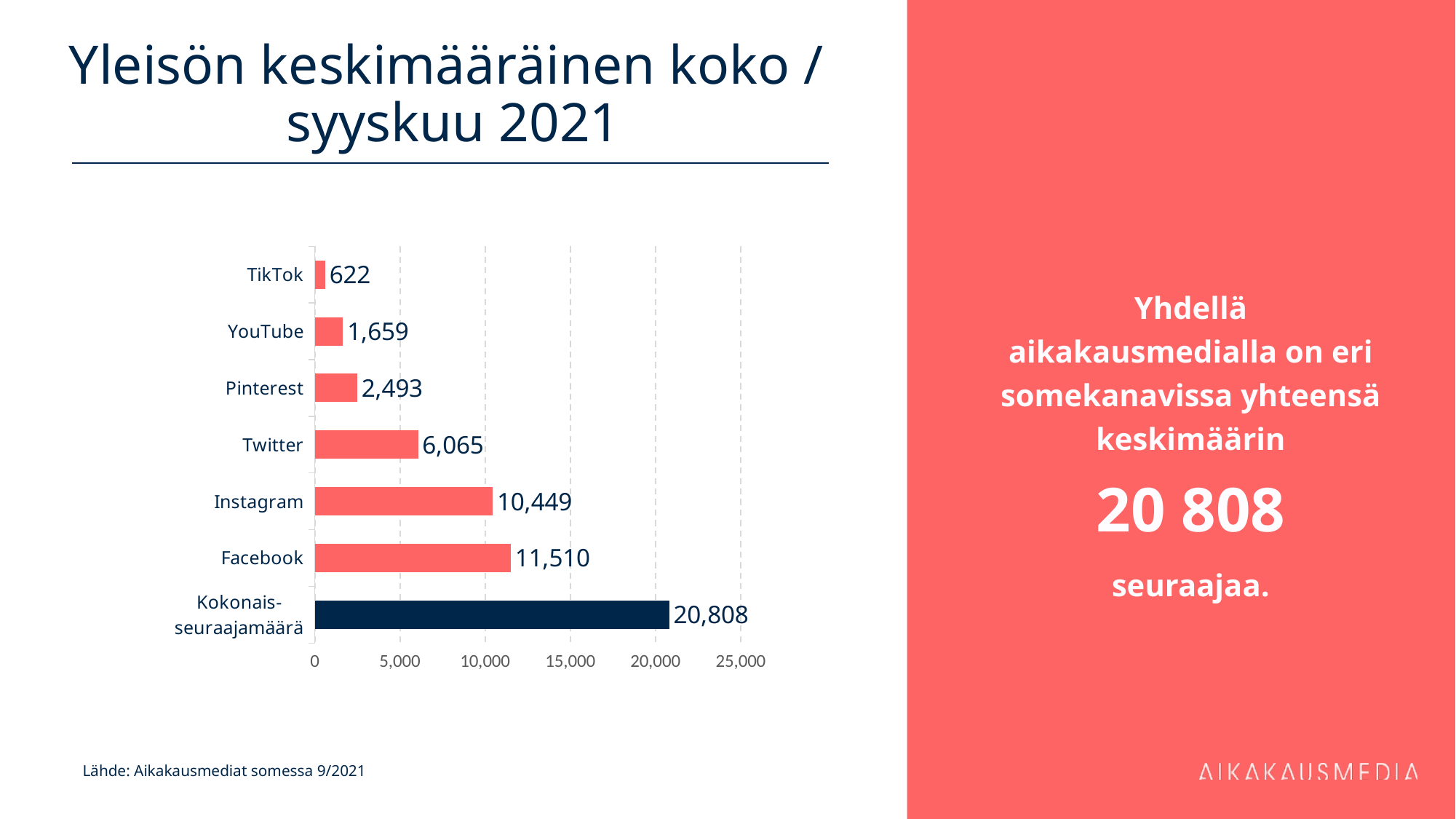
Which is larger, the value for YouTube or the value for Pinterest? Pinterest What is the difference between the values for Twitter and Pinterest? 3,572 What is the difference between the values for Facebook and Instagram? 1,061 What kind of chart is shown on the slide? bar chart Which category has the lowest value? TikTok What is the value for Instagram? 10,449 What is the value for Facebook? 11,510 Is the value for Twitter greater or less than 5,000? greater What is the value for TikTok? 622 Which individual social media channel has the highest value? Facebook How many categories are shown in the chart? 7 What is the value for Kokonais-seuraajamäärä? 20,808